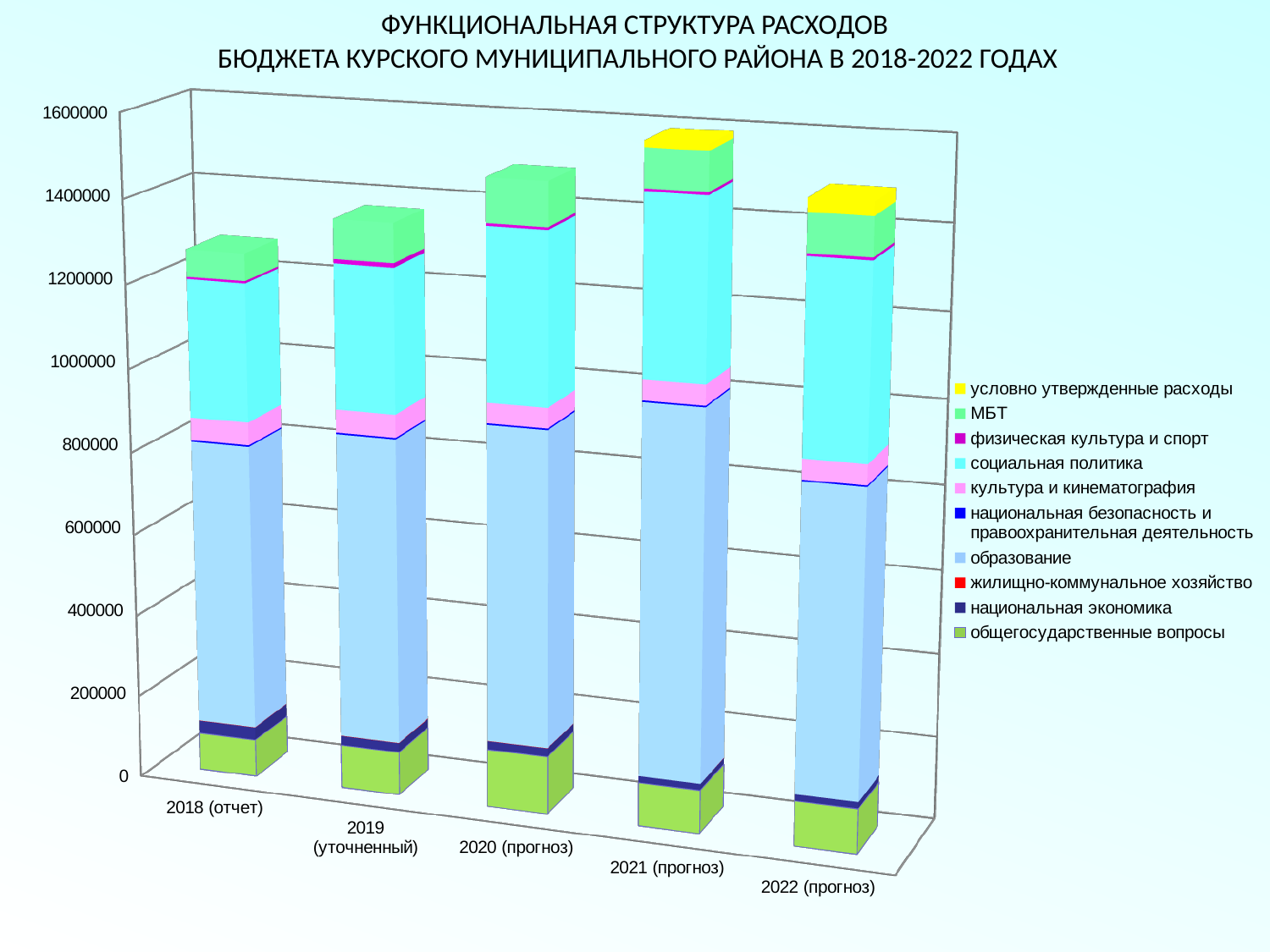
How many series does the legend list? 10 Is the total bar for 2018 (отчет) greater or less than 1400000? less What kind of chart is shown on the slide? stacked bar chart Which year has the tallest total bar? 2021 (прогноз) How many years (categories) are shown along the x axis? 5 Which total bar is larger, 2021 (прогноз) or 2022 (прогноз)? 2021 (прогноз) Is the total bar for 2022 (прогноз) greater or less than 1200000? greater Which colour represents 'условно утвержденные расходы' in the legend? yellow Is the total bar for 2021 (прогноз) greater or less than 1400000? greater Do the total bars rise or fall from 2018 (отчет) to 2021 (прогноз)? rise Which year has the shortest total bar? 2018 (отчет) In which years does the 'условно утвержденные расходы' segment appear in the bars? 2021 (прогноз) and 2022 (прогноз)